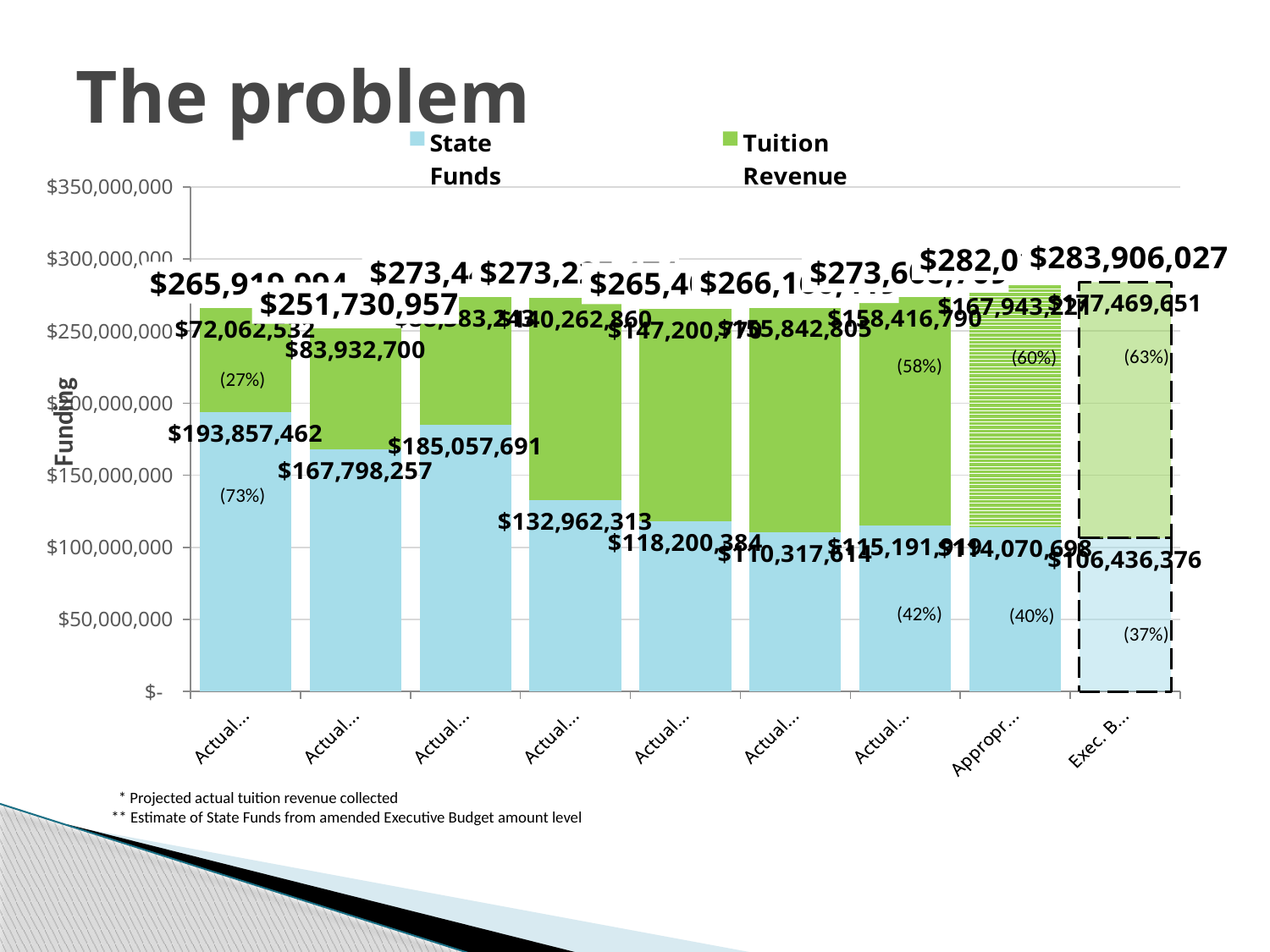
What are the two series named in the legend? State Funds and Tuition Revenue How many bars are plotted in the chart? 9 What is the State Funds value for the leftmost bar? $193,857,462 How many series does the legend list? 2 What kind of chart is shown on the slide? Stacked bar chart What is the difference between the State Funds value in the leftmost bar ($193,857,462) and in the rightmost bar ($106,436,376)? $87,421,086 What is the State Funds value for the rightmost bar (Exec. B...)? $106,436,376 What percentage share of the leftmost bar is State Funds? 73% Which is larger, the State Funds value in the leftmost bar or in the rightmost bar? Leftmost bar What is the total of the rightmost bar (Exec. B...)? $283,906,027 What is the total of the second bar from the left? $251,730,957 What is the Tuition Revenue value for the rightmost bar (Exec. B...)? $177,469,651